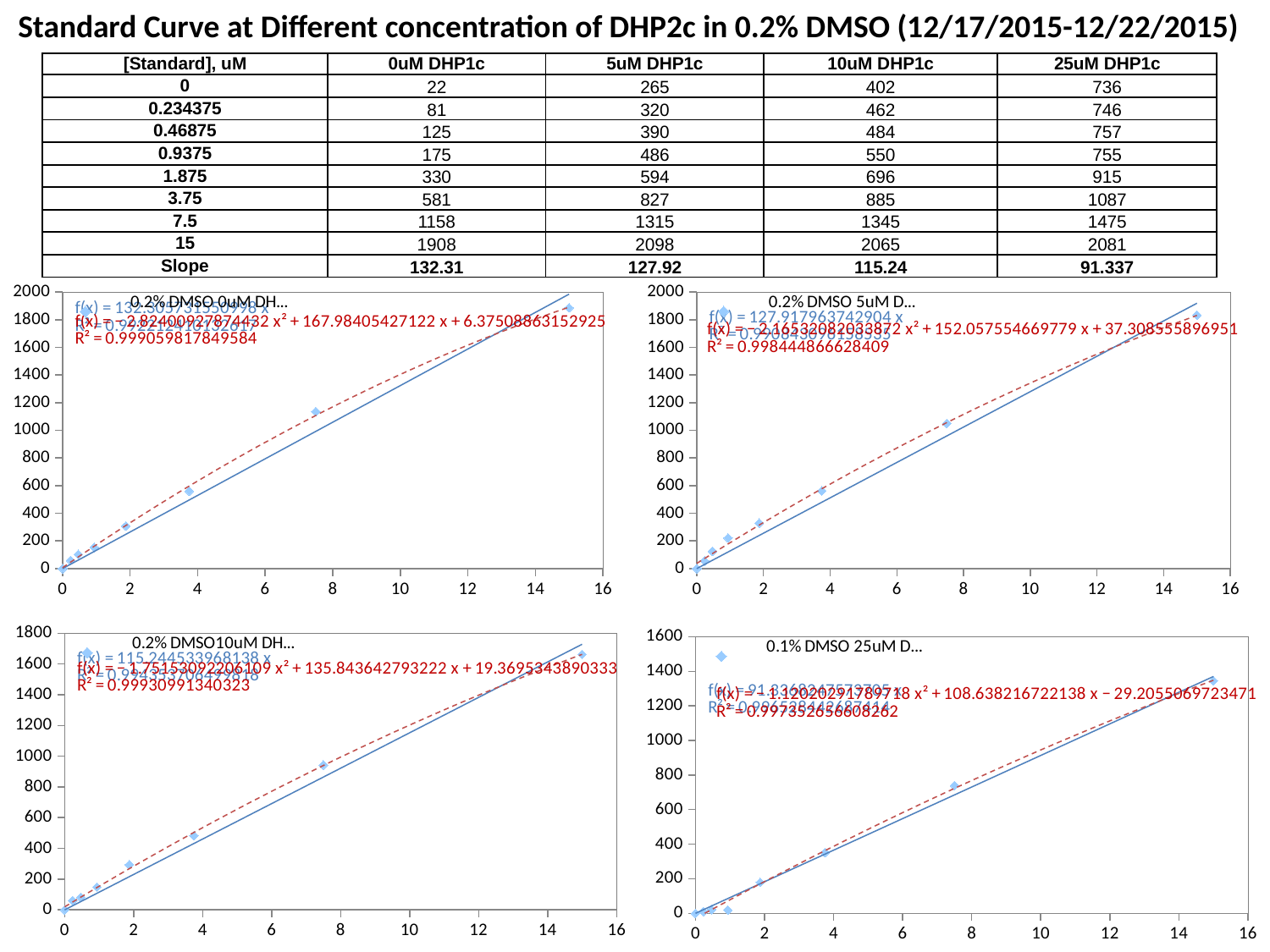
What R² value is printed in red on the bottom-right chart (0.1% DMSO 25uM)? R² = 0.997352656608262 What R² value is printed in red on the top-left chart (0.2% DMSO 0uM)? R² = 0.999059817849584 What is the title of the bottom-right chart? 0.1% DMSO 25uM D... What is the maximum value shown on the y axis of the bottom-left chart (0.2% DMSO 10uM)? 1800 In the top-left chart (0.2% DMSO 0uM), is the value at x = 7.5 greater or less than 1000? greater In the bottom-left chart (0.2% DMSO 10uM), is the value at x = 7.5 greater or less than 1000? less How many data points are plotted in the bottom-right chart titled "0.1% DMSO 25uM D..."? 8 In the top-right chart (0.2% DMSO 5uM), is the value at x = 15 greater or less than 1600? greater In the top-left chart (0.2% DMSO 0uM), do the plotted values rise or fall as x increases from 0 to 15? Rise What kind of chart is the top-left chart titled "0.2% DMSO 0uM DH..."? Scatter chart